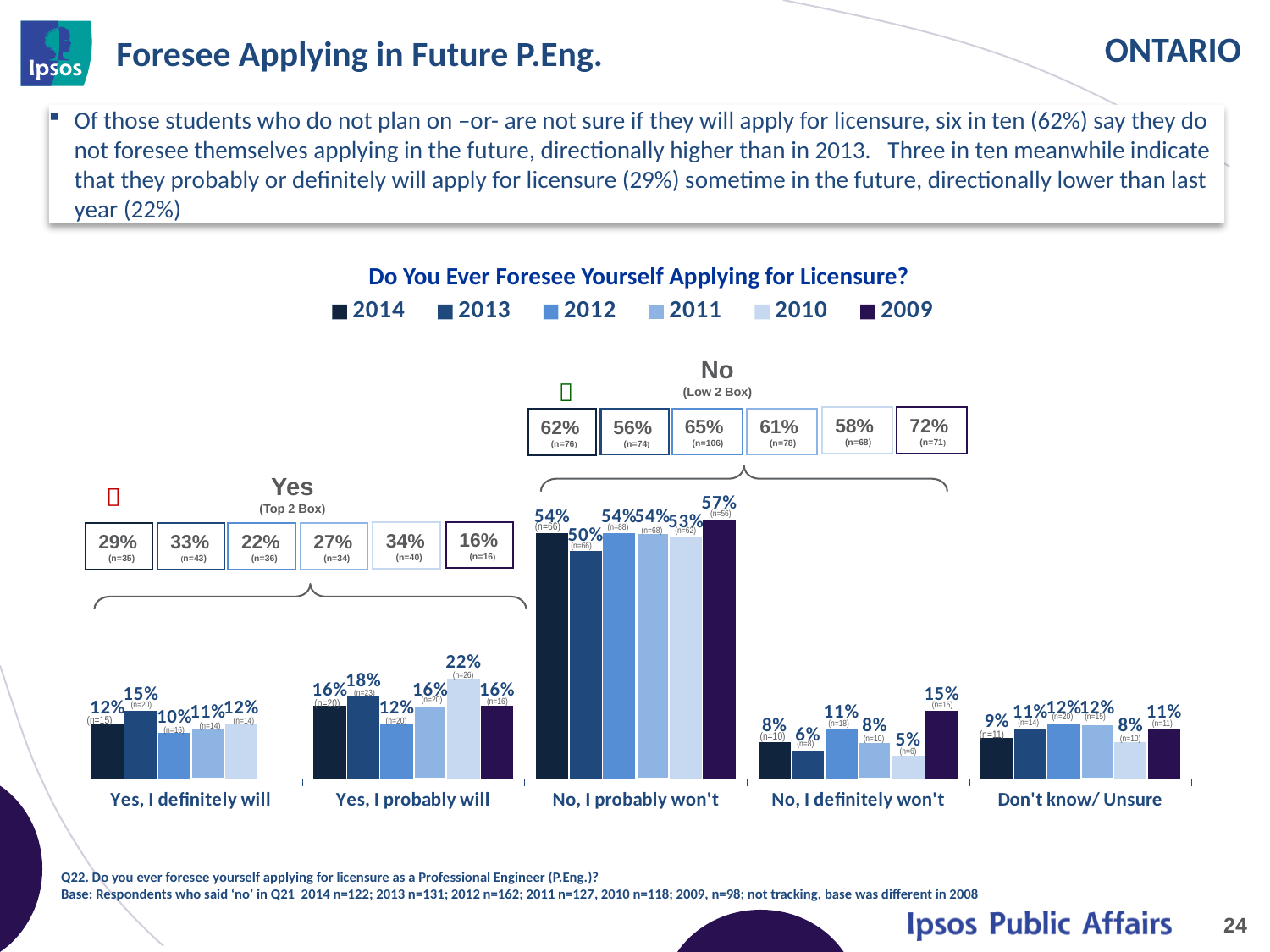
What is the 2014 "Yes (Top 2 Box)" value shown above the chart? 29% What is the difference between the 2009 and 2013 values for "No, I probably won't"? 7 percentage points What is the 2009 "No (Low 2 Box)" value shown above the chart? 72% How many response categories are shown on the x axis? 5 For "Yes, I definitely will", which is larger: the 2013 value or the 2012 value? 2013 Which year has the highest value for "No, I probably won't"? 2009 Which year has the lowest value for "No, I definitely won't"? 2010 What is the 2014 value for "No, I probably won't"? 54% How many years does the legend list? 6 What is the 2010 value for "Yes, I probably will"? 22% What kind of chart is shown? Bar chart What is the 2009 value for "No, I definitely won't"? 15%